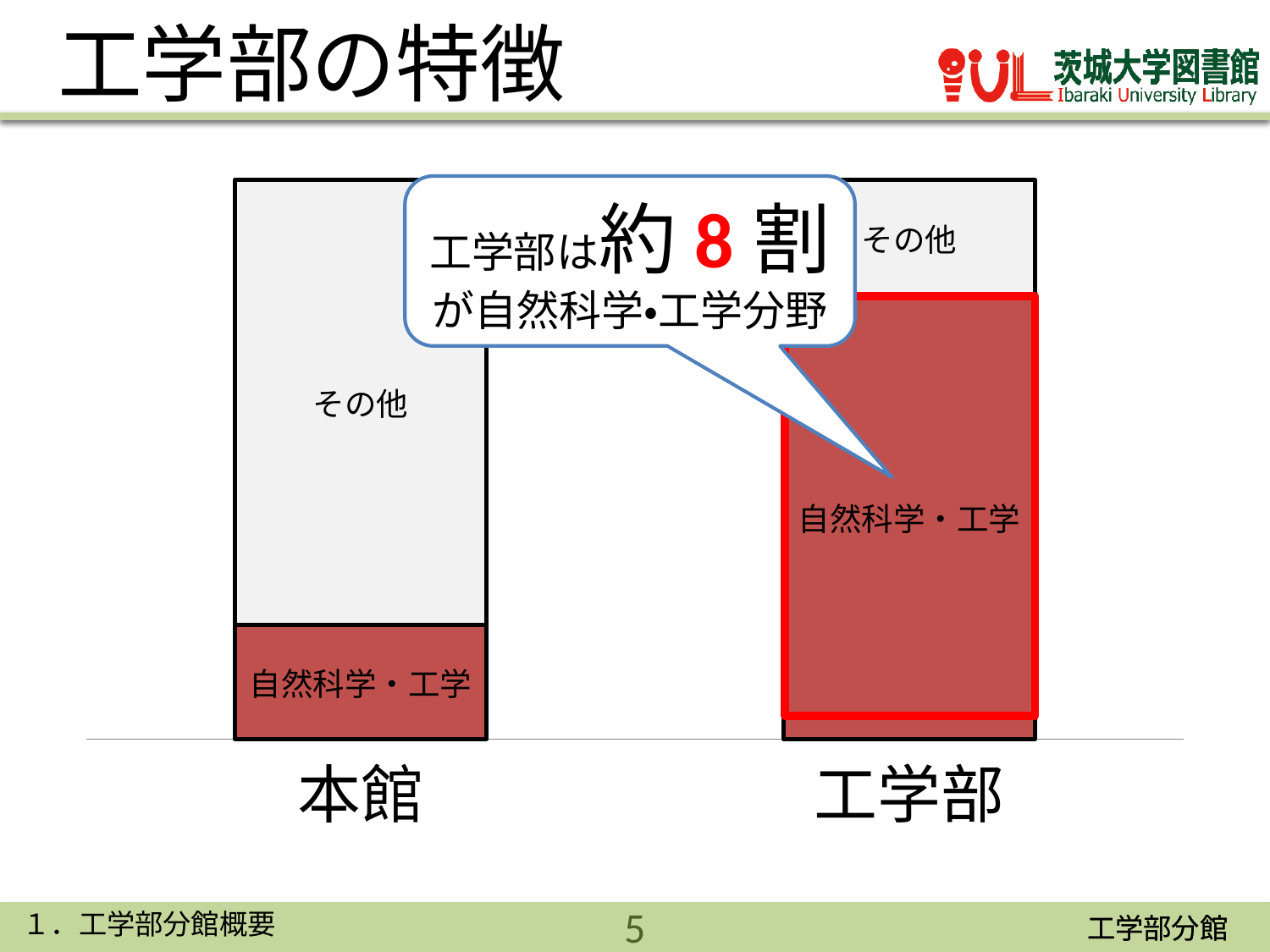
In the 本館 bar, which segment is larger, その他 or 自然科学・工学? その他 In the 工学部 bar, which segment is larger, その他 or 自然科学・工学? 自然科学・工学 What is the title of the slide containing the chart? 工学部の特徴 How many series (segments) make up each stacked bar in the chart? 2 What are the two segments that make up each stacked bar? その他, 自然科学・工学 According to the callout on the chart, roughly what share of 工学部 is in the 自然科学・工学 field? 約8割 Which category has the largest 自然科学・工学 segment? 工学部 What kind of chart is shown on the slide? stacked bar chart Which category has the larger 自然科学・工学 segment, 本館 or 工学部? 工学部 How many categories (bars) are shown on the x axis of the chart? 2 What are the two categories shown on the x axis of the chart? 本館, 工学部